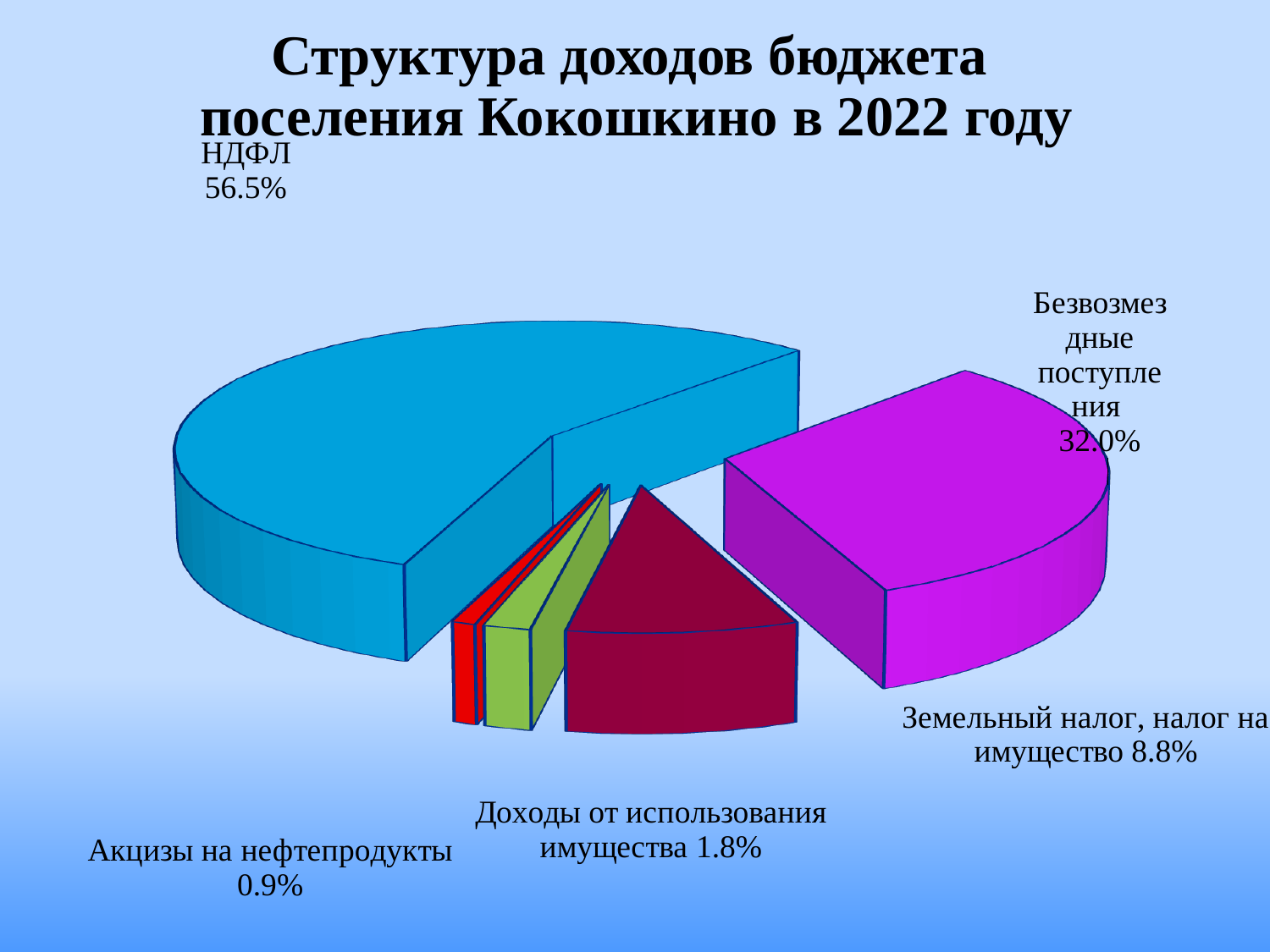
What kind of chart is shown on the slide? Pie chart What share is shown for Акцизы на нефтепродукты? 0.9% What share is shown for Земельный налог, налог на имущество? 8.8% Which category has the largest share of the budget revenue? НДФЛ Which is larger: the share of Земельный налог, налог на имущество or the share of Доходы от использования имущества? Земельный налог, налог на имущество Which category has the smallest share of the budget revenue? Акцизы на нефтепродукты What share of the budget revenue is НДФЛ? 56.5% How many slices does the pie chart have? 5 What share is shown for Безвозмездные поступления? 32.0% What share is shown for Доходы от использования имущества? 1.8% What is the title of the chart? Структура доходов бюджета поселения Кокошкино в 2022 году What is the difference in percentage points between НДФЛ and Безвозмездные поступления? 24.5